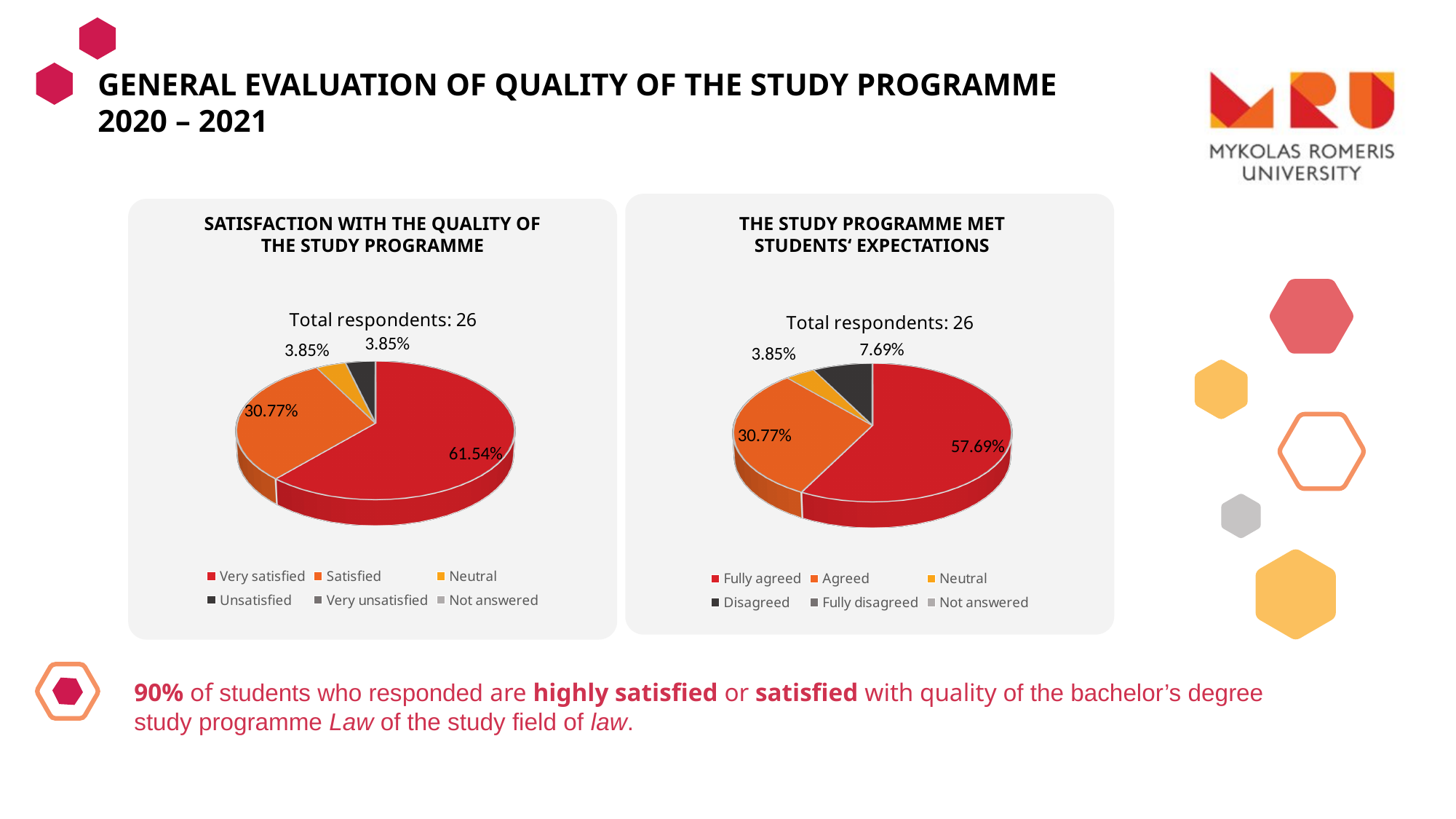
Which is larger: the Very satisfied share in the left chart or the Fully agreed share in the right chart? Very satisfied (left chart) In the 'Satisfaction with the quality of the study programme' chart, what share of respondents were very satisfied? 61.54% In the 'The study programme met students' expectations' chart, what share of respondents disagreed? 7.69% In the 'The study programme met students' expectations' chart, what is the difference between the Disagreed and Neutral shares? 3.84% In the 'Satisfaction with the quality of the study programme' chart, what share of respondents were satisfied? 30.77% What type of chart is used in 'The study programme met students' expectations'? Pie chart How many respondents are reported for the 'The study programme met students' expectations' chart? 26 In the 'The study programme met students' expectations' chart, which category has the largest slice? Fully agreed In the 'Satisfaction with the quality of the study programme' chart, what is the difference between the Very satisfied and Satisfied shares? 30.77% In the 'Satisfaction with the quality of the study programme' chart, which category has the largest slice? Very satisfied How many entries does the legend of the 'Satisfaction with the quality of the study programme' chart list? 6 In the 'The study programme met students' expectations' chart, what share of respondents fully agreed? 57.69%